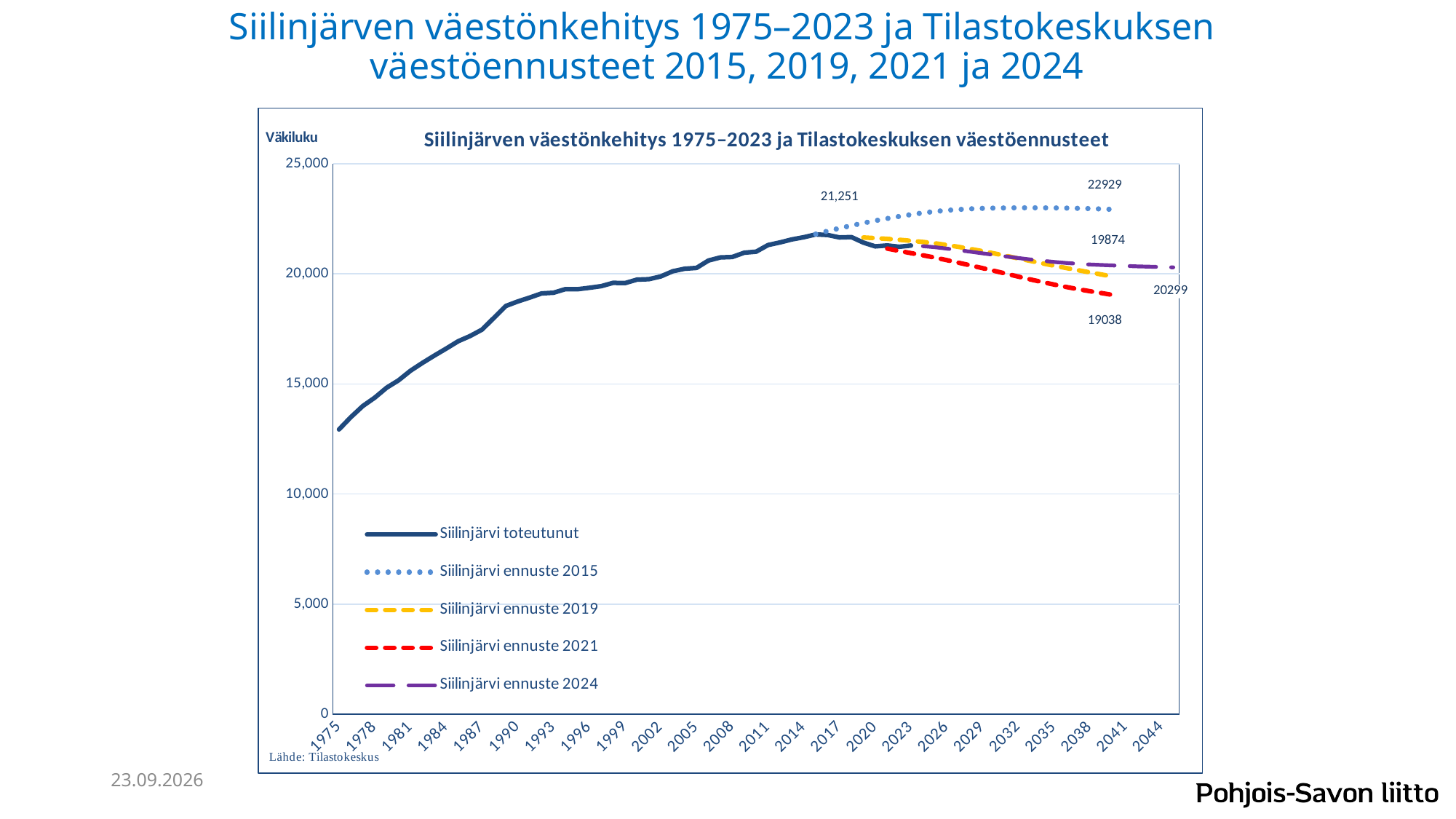
What is the final labelled value of the Siilinjärvi ennuste 2021 series? 19038 What is the final labelled value of the Siilinjärvi ennuste 2024 series? 20299 How many series does the legend list? 5 Is the Siilinjärvi toteutunut value in 1975 greater or less than 15,000? less What kind of chart is shown on the slide? line chart What is the difference between the final labelled values of the ennuste 2015 and ennuste 2021 series? 3891 Which forecast series ends at the lowest labelled value? Siilinjärvi ennuste 2021 Does the Siilinjärvi toteutunut line rise or fall from 1975 to 2014? rise Which forecast series ends at the highest labelled value? Siilinjärvi ennuste 2015 Which ends higher, the ennuste 2019 series or the ennuste 2024 series? Siilinjärvi ennuste 2024 What is the final labelled value of the Siilinjärvi ennuste 2015 series? 22929